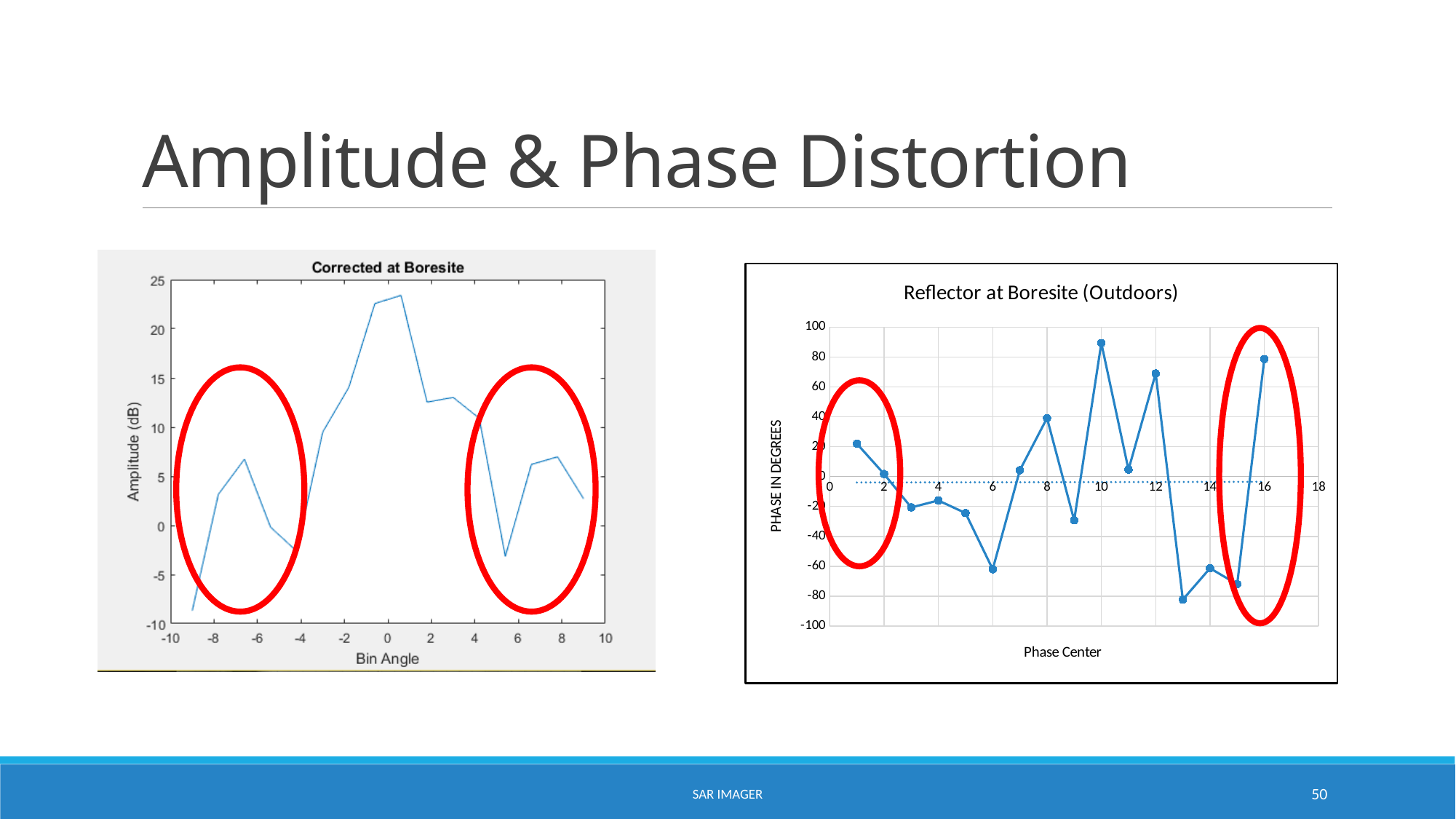
In the 'Reflector at Boresite (Outdoors)' chart, which has the larger phase: phase center 16 or phase center 8? phase center 16 In the 'Corrected at Boresite' chart, is the peak amplitude greater or less than 20 dB? greater In the 'Reflector at Boresite (Outdoors)' chart, at which phase center is the phase lowest? 13 What kind of chart is the 'Reflector at Boresite (Outdoors)' chart? line chart In the 'Reflector at Boresite (Outdoors)' chart, which has the larger phase: phase center 10 or phase center 12? phase center 10 In the 'Reflector at Boresite (Outdoors)' chart, is the phase at phase center 6 greater or less than -40? less What kind of chart is the 'Corrected at Boresite' chart on the left? line chart In the 'Corrected at Boresite' chart, is the amplitude at bin angle -9 greater or less than -5 dB? less What is the y-axis label of the 'Reflector at Boresite (Outdoors)' chart? PHASE IN DEGREES In the 'Reflector at Boresite (Outdoors)' chart, at which phase center is the phase highest? 10 In the 'Reflector at Boresite (Outdoors)' chart, how many data points are plotted? 16